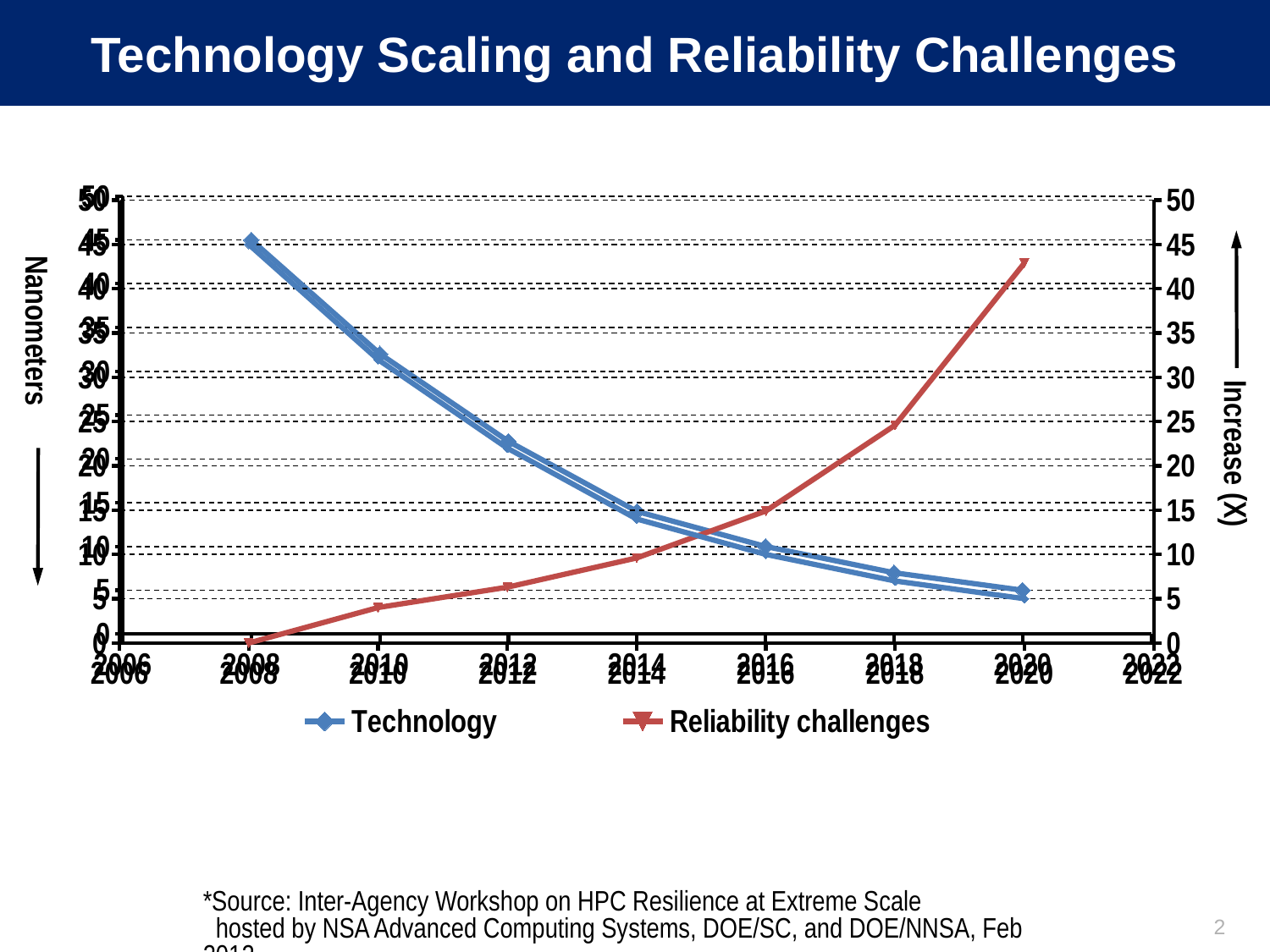
How many data points does the Technology series have? 7 In which year is the Reliability challenges series at its lowest? 2008 Does the Technology series rise or fall from 2008 to 2020? fall What kind of chart is shown on the slide? line chart Is the Technology value for 2010 greater or less than 30? greater In which year is the Technology series at its highest? 2008 Does the Reliability challenges series rise or fall from 2008 to 2020? rise Is the Reliability challenges value for 2020 greater or less than 40? greater What is the label of the left vertical axis? Nanometers In 2020, which series has the larger value, Technology or Reliability challenges? Reliability challenges How many series does the legend list? 2